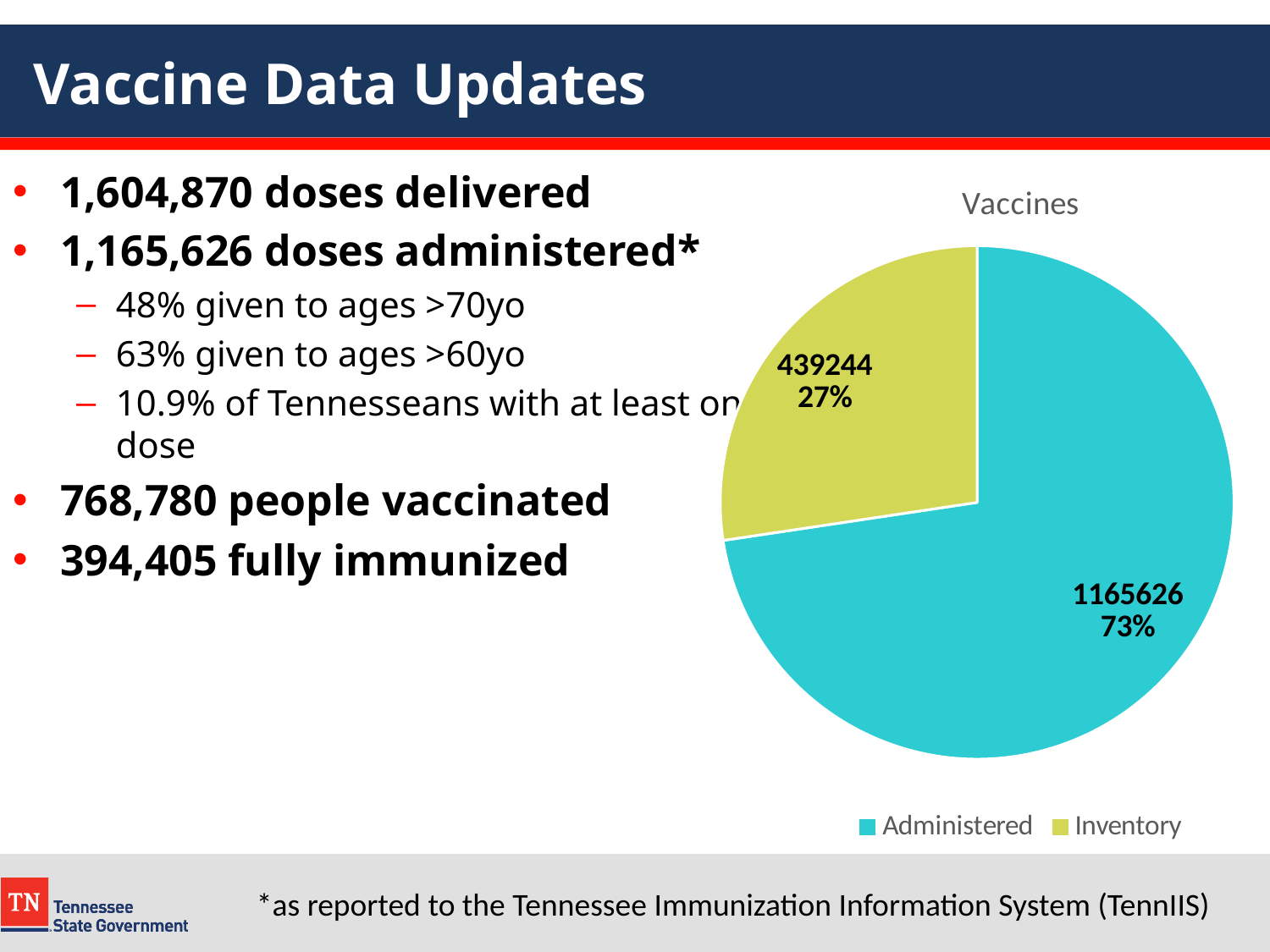
Which slice of the pie chart is the largest? Administered What colour is the Inventory slice? Yellow-green Which is larger, Administered or Inventory? Administered What is the difference between the Administered and Inventory values? 726382 What is the value for Administered in the pie chart? 1165626 What is the value for Inventory in the pie chart? 439244 What type of chart is shown on the slide? Pie chart How many slices does the pie chart have? 2 Which slice of the pie chart is the smallest? Inventory What share of the pie does the Inventory slice represent? 27% What share of the pie does the Administered slice represent? 73% What is the title of the chart? Vaccines